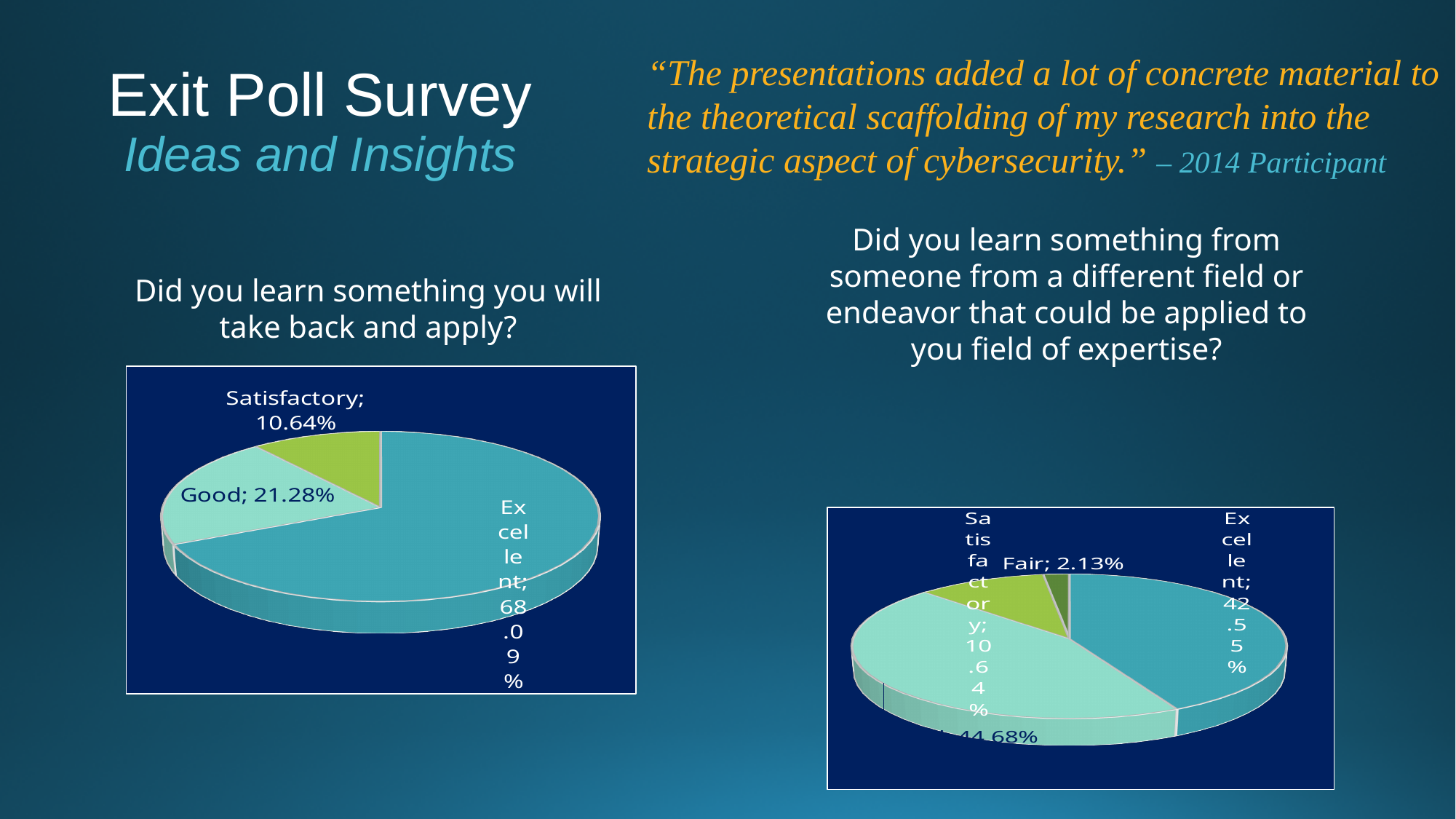
In the chart 'Did you learn something you will take back and apply?', how many slices does the pie have? 3 In the chart 'Did you learn something you will take back and apply?', what share of responses is Satisfactory? 10.64% In the chart 'Did you learn something from someone from a different field or endeavor that could be applied to you field of expertise?', which response category has the smallest share? Fair In the chart 'Did you learn something you will take back and apply?', what share of responses is Good? 21.28% In the chart 'Did you learn something you will take back and apply?', which response category has the smallest share? Satisfactory In the chart 'Did you learn something from someone from a different field or endeavor that could be applied to you field of expertise?', how many slices does the pie have? 4 In the chart 'Did you learn something from someone from a different field or endeavor that could be applied to you field of expertise?', what share of responses is Fair? 2.13% In the chart 'Did you learn something you will take back and apply?', which response category has the largest share? Excellent What kind of chart is used for 'Did you learn something you will take back and apply?'? Pie chart In the chart 'Did you learn something you will take back and apply?', what share of responses is Excellent? 68.09% In the chart 'Did you learn something from someone from a different field or endeavor that could be applied to you field of expertise?', what share of responses is Excellent? 42.55% In the chart 'Did you learn something you will take back and apply?', what is the difference in percentage points between Excellent and Good? 46.81